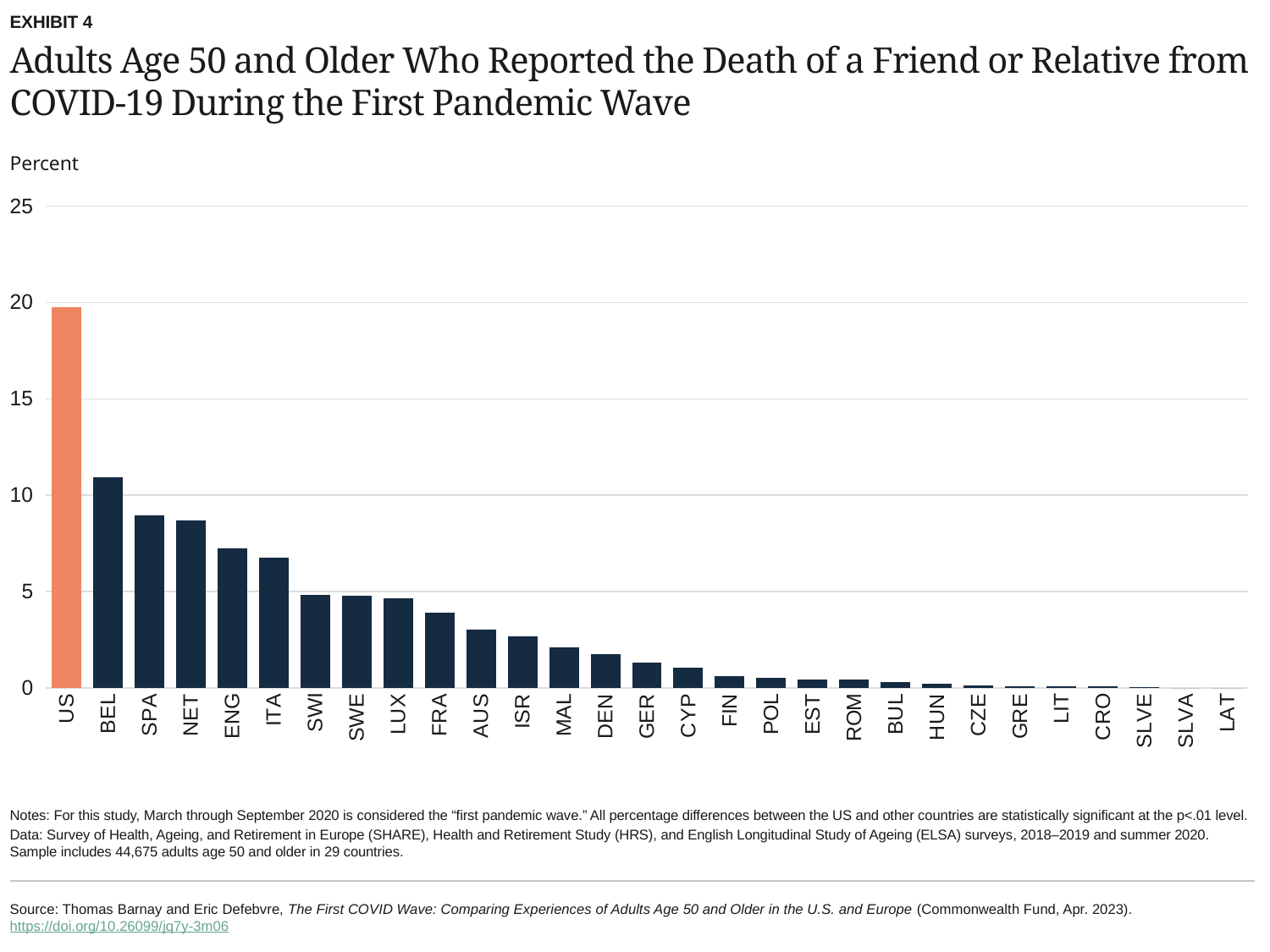
Which country has the highest percentage of adults age 50 and older reporting the death of a friend or relative from COVID-19? US Do the values rise or fall moving from left to right along the x axis? Fall Is the value for ENG greater or less than 5? greater Is the value for BEL greater or less than 10? greater Which has a higher value, US or BEL? US Which country's bar is shown in a different colour (orange) from the rest? US Is the value for SPA greater or less than 10? less How many countries are shown on the x axis of the chart? 29 Which has a higher value, ITA or SWI? ITA What kind of chart is shown on the slide? Bar chart